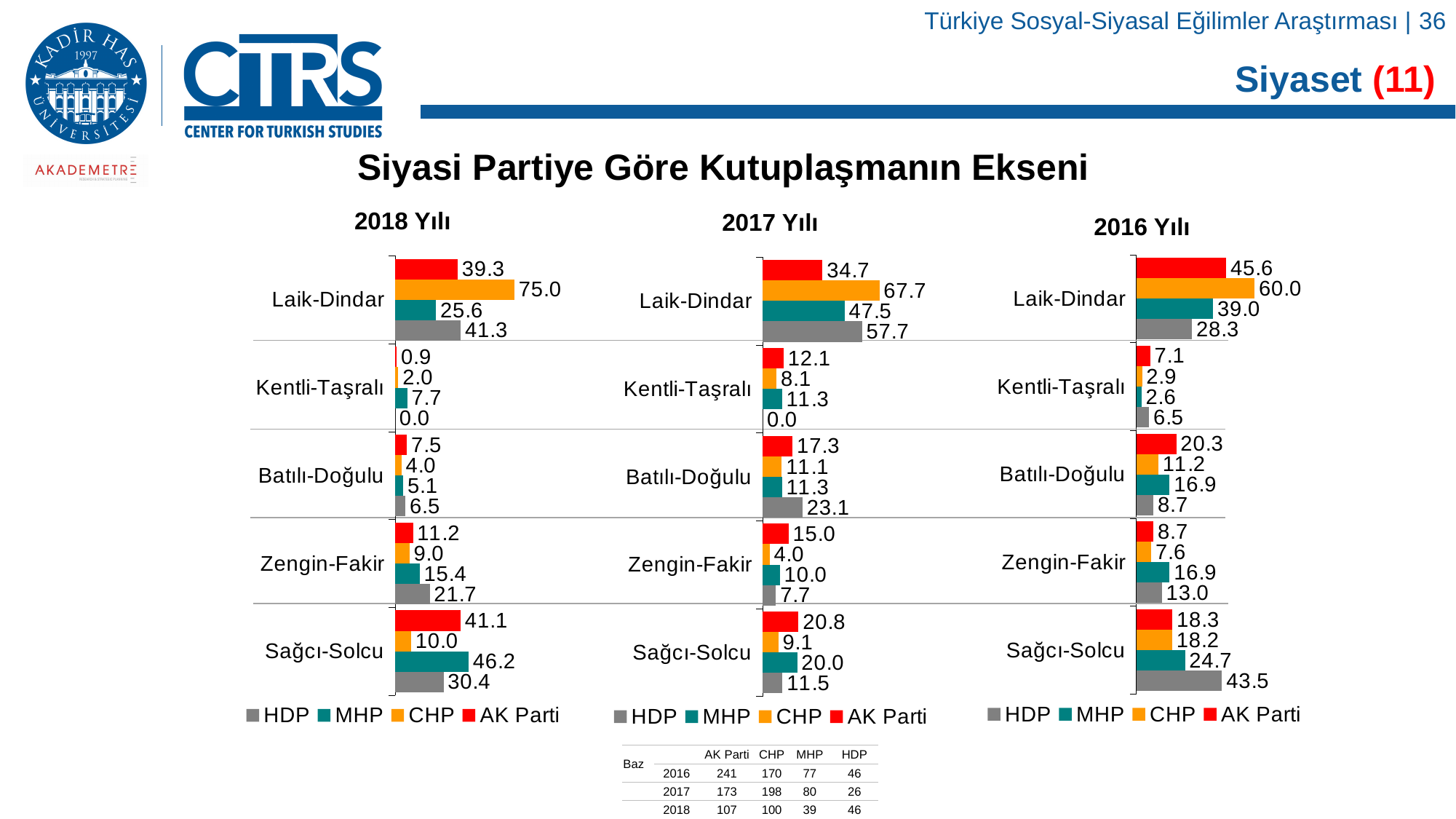
How many series does the legend of the 2017 Yılı chart list? 4 In the 2018 Yılı chart, what is the CHP value for Laik-Dindar? 75.0 In the 2017 Yılı chart, what is the HDP value for Batılı-Doğulu? 23.1 In the 2017 Yılı chart, what is the difference between the CHP and AK Parti values for Laik-Dindar? 33.0 In the 2016 Yılı chart, what is the AK Parti value for Laik-Dindar? 45.6 In the 2016 Yılı chart, which is larger for Sağcı-Solcu: the HDP value or the MHP value? HDP In the 2016 Yılı chart, which party has the lowest value for Kentli-Taşralı? MHP In the 2018 Yılı chart, what is the HDP value for Kentli-Taşralı? 0.0 In the 2018 Yılı chart, which party has the highest value for Sağcı-Solcu? MHP What type of chart is the 2016 Yılı chart? Bar chart What colour represents AK Parti in the charts? Red How many categories are shown in the 2018 Yılı chart? 5